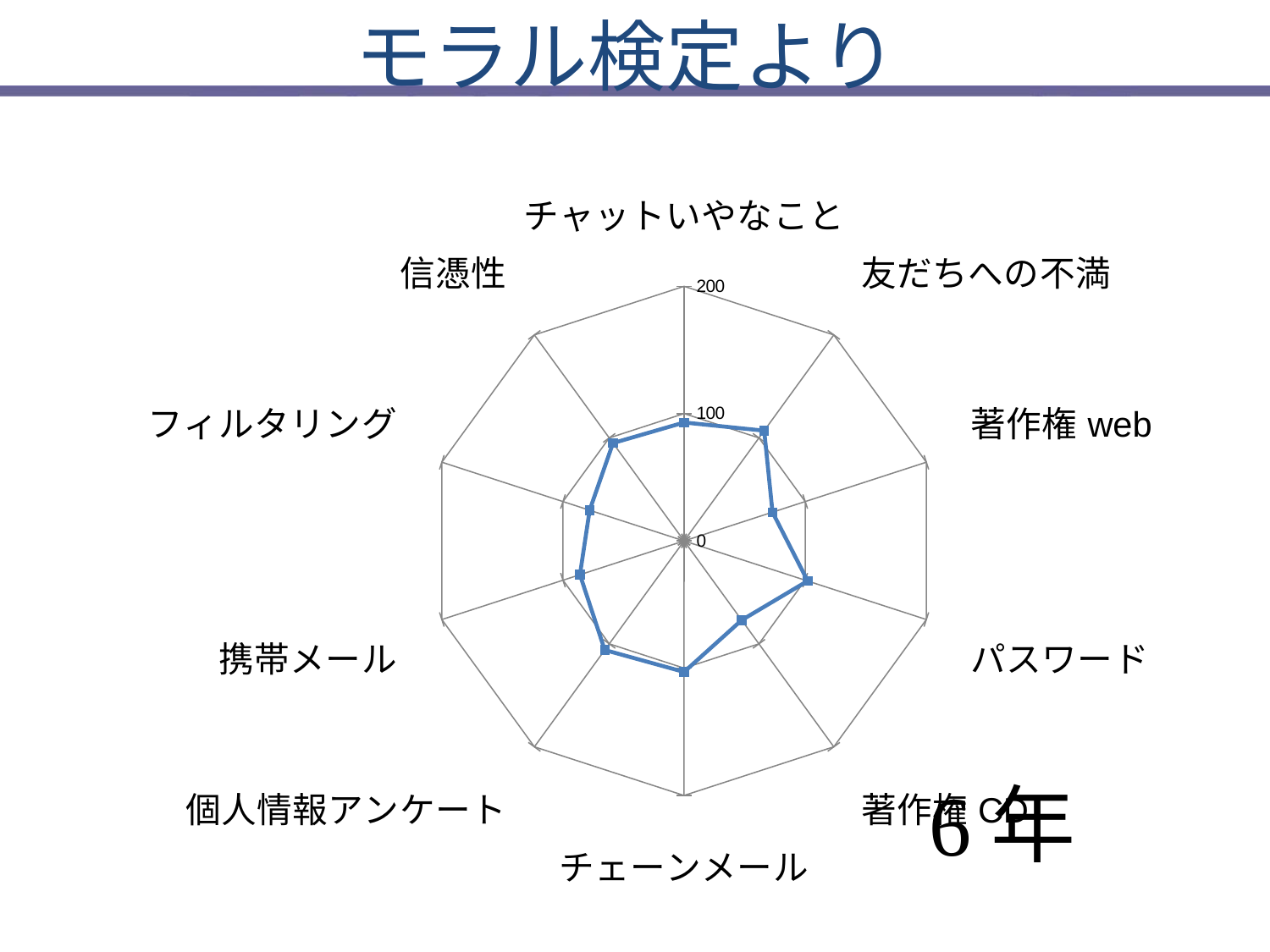
Which has the larger value, 個人情報アンケート or フィルタリング? 個人情報アンケート What is the maximum value shown on the radar chart's axis scale? 200 What kind of chart is shown on the slide? Radar chart Is the value for フィルタリング greater or less than 100? less Is the value for 著作権 web greater or less than 100? less Is the value for 携帯メール greater or less than 100? less What is the title of the slide containing the radar chart? モラル検定より Which has the larger value, パスワード or 著作権 web? パスワード Which has the larger value, チェーンメール or 著作権 CD? チェーンメール How many categories (axes) does the radar chart have? 10